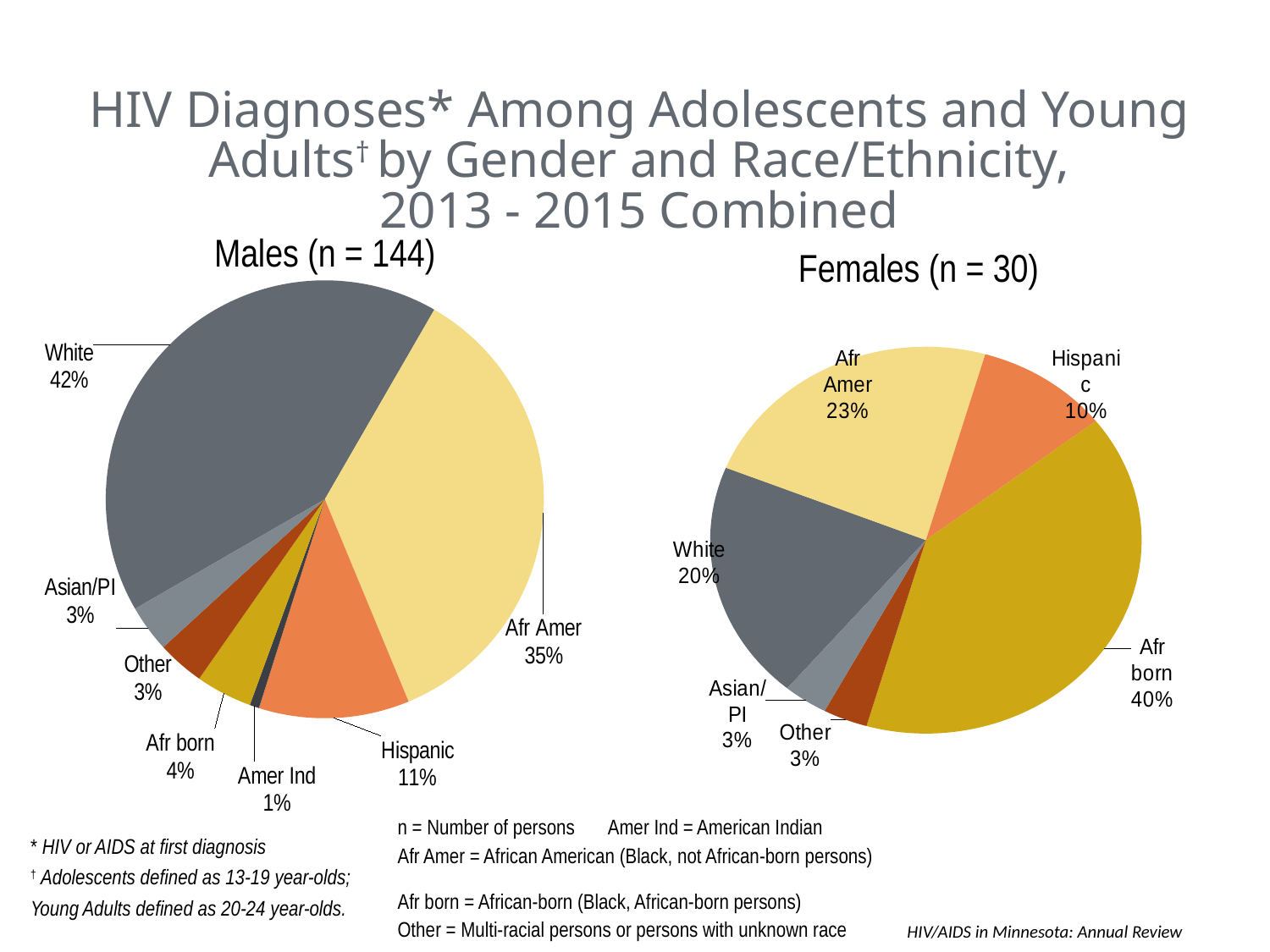
In the Females (n = 30) pie chart, which is larger, the share for White or the share for Hispanic? White In the Males (n = 144) pie chart, which category has the smallest share? Amer Ind In the Males (n = 144) pie chart, what percentage is shown for Hispanic? 11% In the Males (n = 144) pie chart, which category has the largest share? White In the Females (n = 30) pie chart, which category has the largest share? Afr born In the Males (n = 144) pie chart, what percentage is shown for White? 42% In the Females (n = 30) pie chart, what percentage is shown for Afr born? 40% How many categories are shown in the Males (n = 144) pie chart? 7 What type of chart is used for the Females (n = 30) data? Pie chart In the Males (n = 144) pie chart, what is the difference in percentage points between White and Afr Amer? 7 In the Females (n = 30) pie chart, what percentage is shown for Afr Amer? 23% How many categories are shown in the Females (n = 30) pie chart? 6